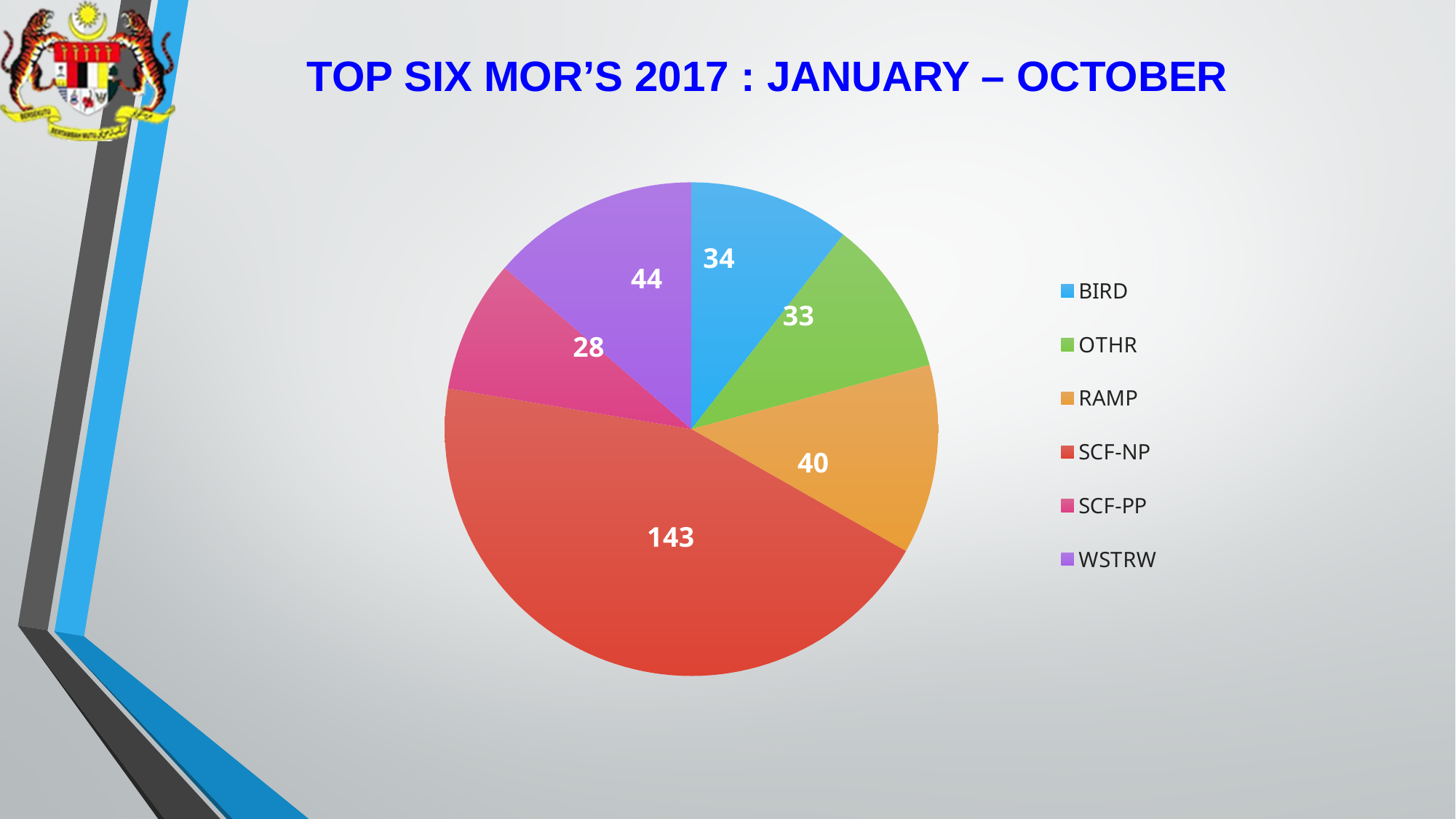
What is the value shown for RAMP? 40 What is the value shown for SCF-PP? 28 How many categories are shown in the pie chart? 6 Which is larger, the WSTRW slice or the BIRD slice? WSTRW What is the difference between the RAMP value and the SCF-PP value? 12 Which category has the largest slice of the pie? SCF-NP Which category has the smallest slice of the pie? SCF-PP What is the value of the SCF-NP slice in the pie chart? 143 What is the difference between the SCF-NP value and the WSTRW value? 99 What type of chart is shown on the slide? Pie chart What is the title of the chart on the slide? TOP SIX MOR'S 2017 : JANUARY – OCTOBER What is the value of the WSTRW slice? 44